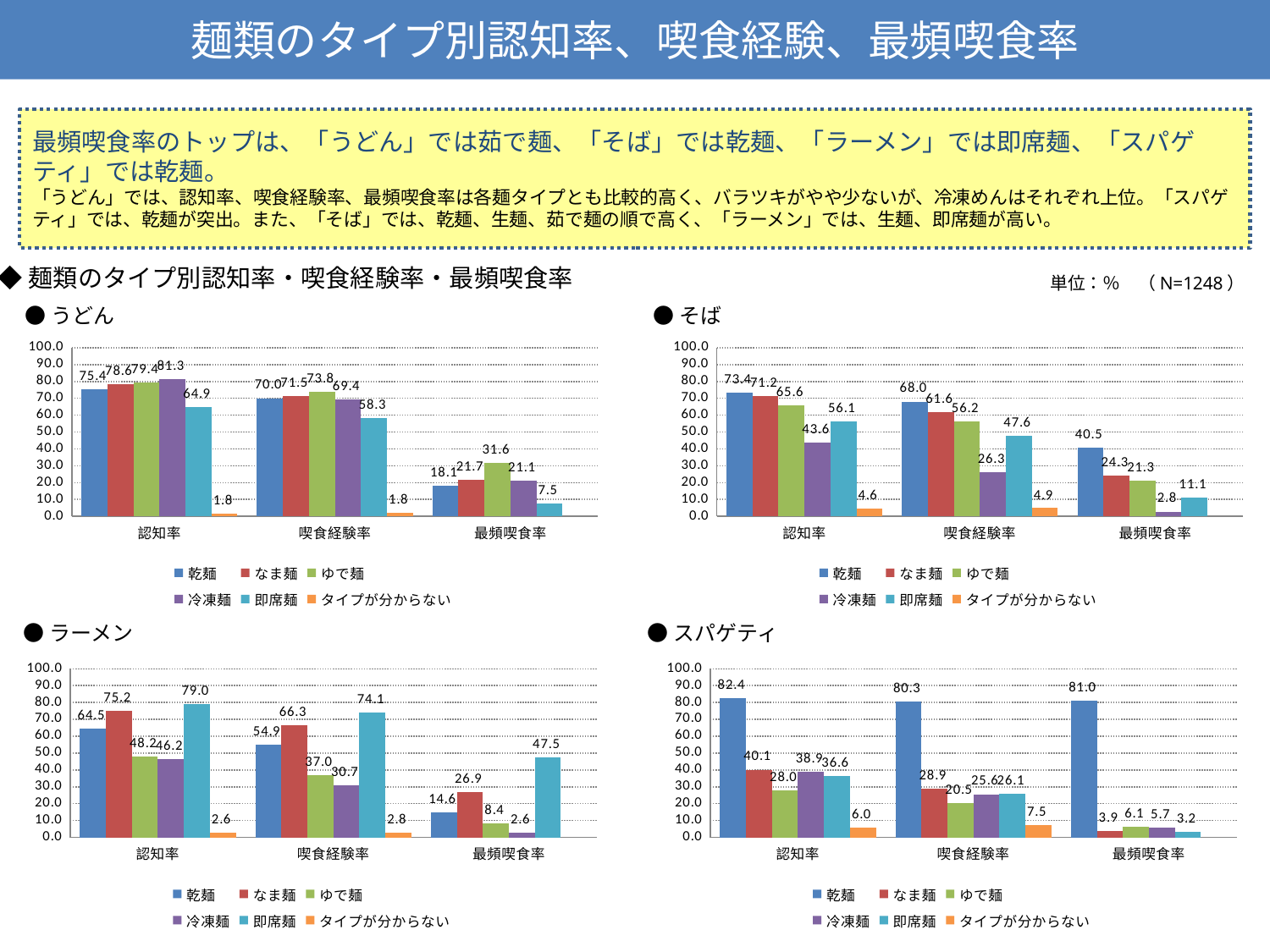
In the そば chart, is the 喫食経験率 for 冷凍麺 greater or less than 30.0? less In the スパゲティ chart, what is the difference between the 認知率 for 乾麺 and for なま麺? 42.3 How many series does the legend of the ラーメン chart list? 6 In the うどん chart, which is larger: the 認知率 for 冷凍麺 or for 即席麺? 冷凍麺 In the ラーメン chart, what is the 喫食経験率 value for 即席麺? 74.1 In the スパゲティ chart, what is the 最頻喫食率 value for 乾麺? 81.0 In the そば chart, do the values for 乾麺 rise or fall from 認知率 to 最頻喫食率? fall In the うどん chart, what is the 最頻喫食率 value for ゆで麺? 31.6 What kind of chart is the スパゲティ chart? bar chart In the そば chart, what is the 認知率 value for 乾麺? 73.4 In the ラーメン chart, which noodle type has the highest 最頻喫食率? 即席麺 In the そば chart, which noodle type has the lowest 認知率? タイプが分からない